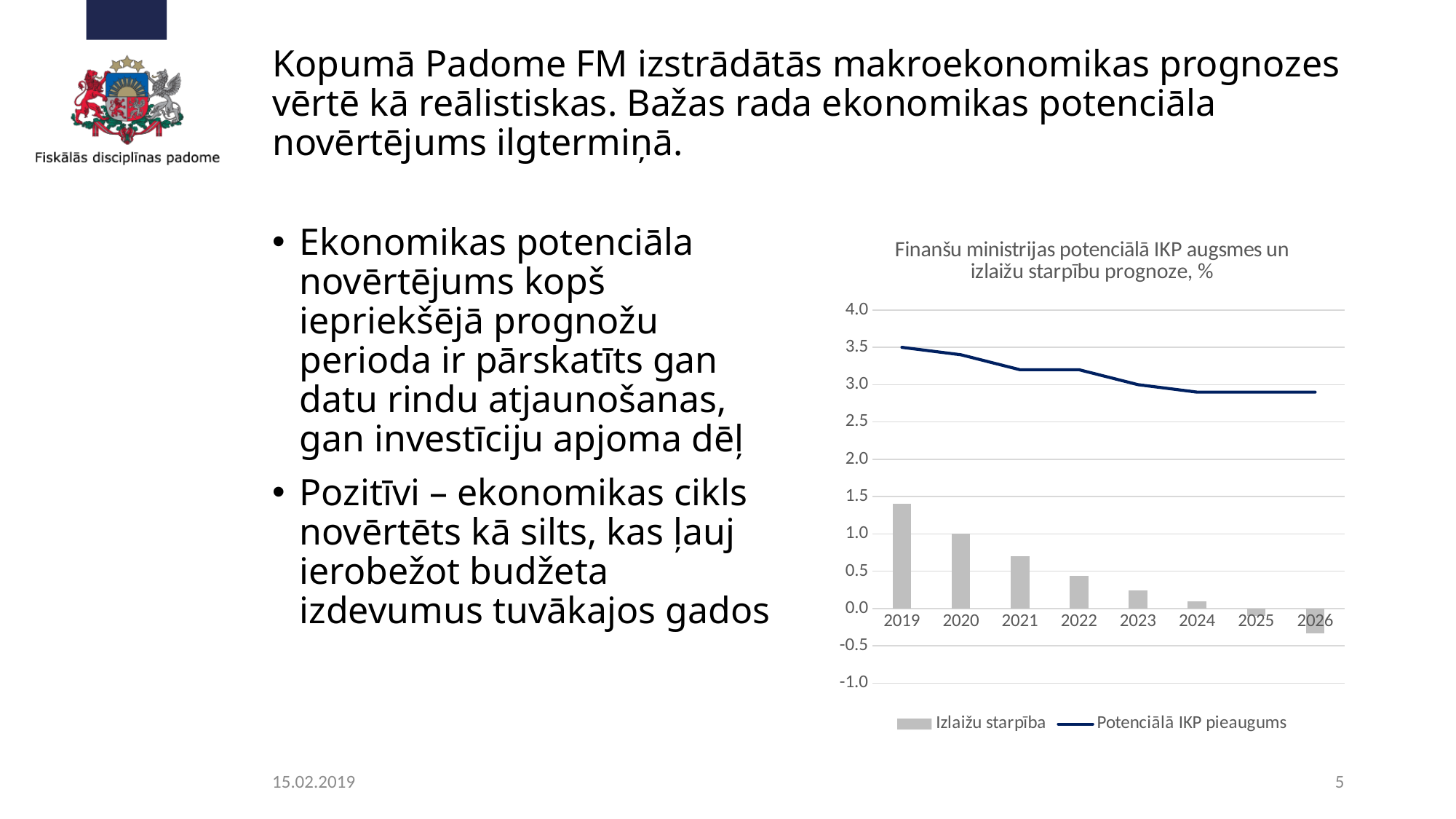
What is the title of the chart? Finanšu ministrijas potenciālā IKP augsmes un izlaižu starpību prognoze, % Is the value for Izlaižu starpība in 2019 greater or less than 1.0? greater Which series is shown as a line in the chart? Potenciālā IKP pieaugums How many series does the chart legend list? 2 How many years are shown on the x axis of the chart? 8 Which year has the lowest value for Izlaižu starpība? 2026 What kind of chart is shown on the slide? A combined bar and line chart Is the value for Potenciālā IKP pieaugums in 2026 greater or less than 3.0? less Does the Potenciālā IKP pieaugums line rise or fall from 2019 to 2026? Fall Is the value for Izlaižu starpība in 2026 greater or less than 0.0? less Which year has the highest value for Izlaižu starpība? 2019 Which is larger, the Izlaižu starpība value for 2020 or for 2023? 2020